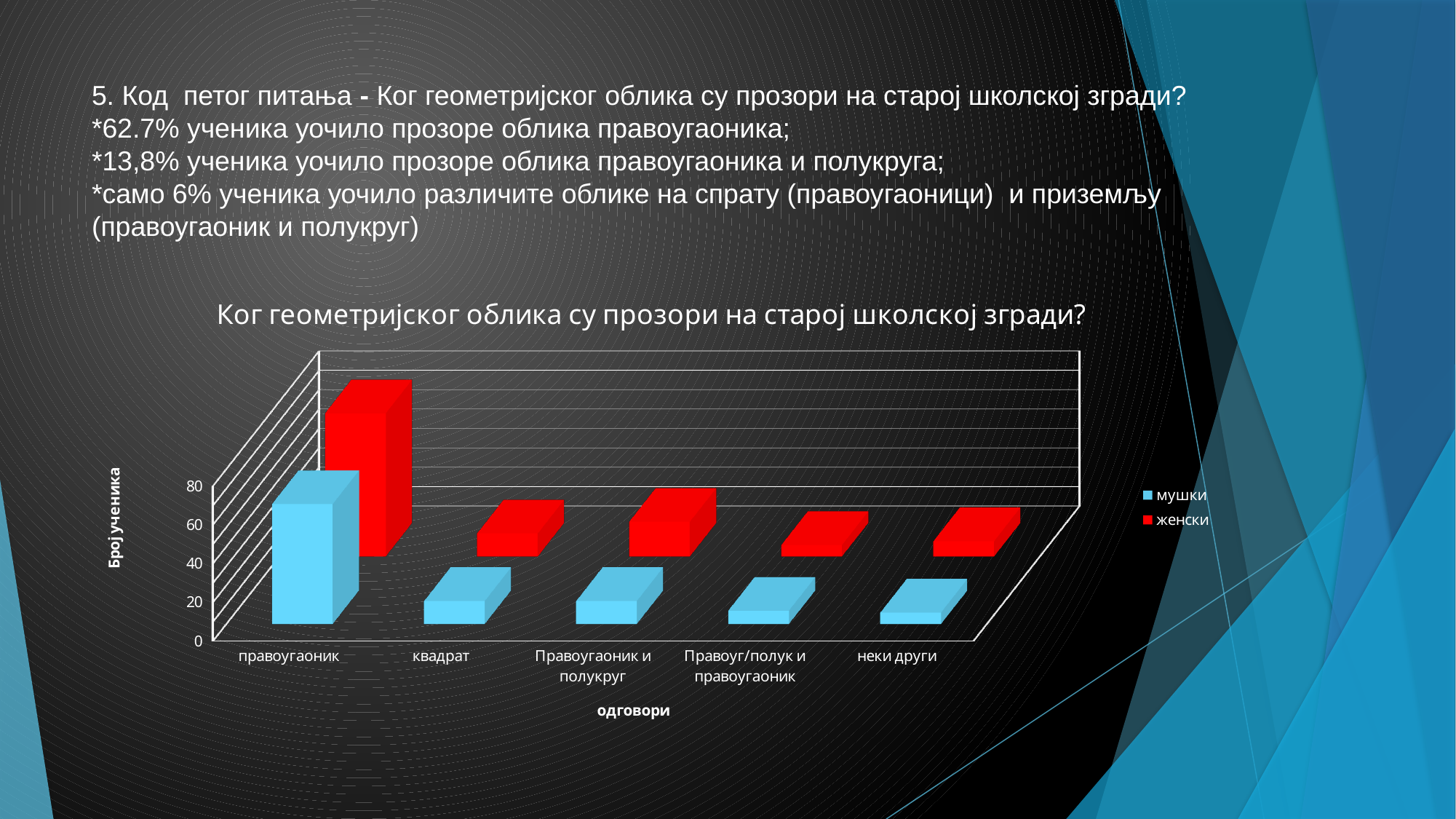
For the мушки series, is the value for квадрат greater or less than 40? less What kind of chart is shown on the slide? bar chart How many categories are shown on the x axis of the chart? 5 What is the title of the chart? Ког геометријског облика су прозори на старој школској згради? Which category has the highest value for the женски series? правоугаоник For the женски series, which is larger: правоугаоник or неки други? правоугаоник For the мушки series, is the value for правоугаоник greater or less than 40? greater How many series does the legend list? 2 What is the label of the vertical axis of the chart? Број ученика For the мушки series, which is larger: правоугаоник or квадрат? правоугаоник Which category has the highest value for the мушки series? правоугаоник